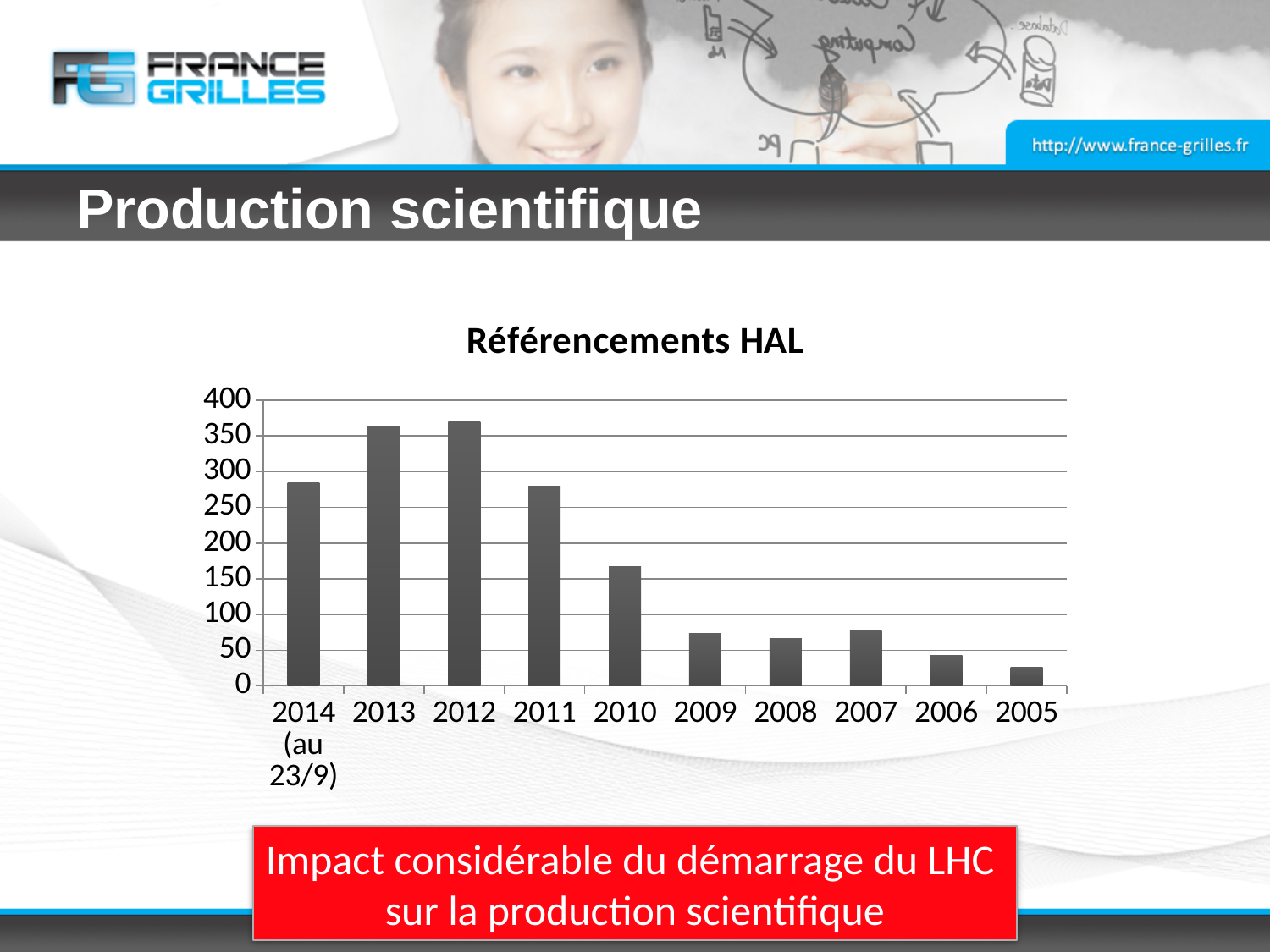
Which year has the lowest number of HAL references? 2005 What kind of chart is shown on the slide? bar chart Is the value for 2013 greater or less than 350? greater Which year has the larger value, 2013 or 2010? 2013 Moving along the x axis from 2014 to 2005, do the values generally rise or fall? fall Is the value for 2010 greater or less than 150? greater Is the value for 2009 greater or less than 100? less Which year has the larger value, 2009 or 2006? 2009 What is the title of the chart? Référencements HAL How many years (categories) are shown on the x axis of the chart? 10